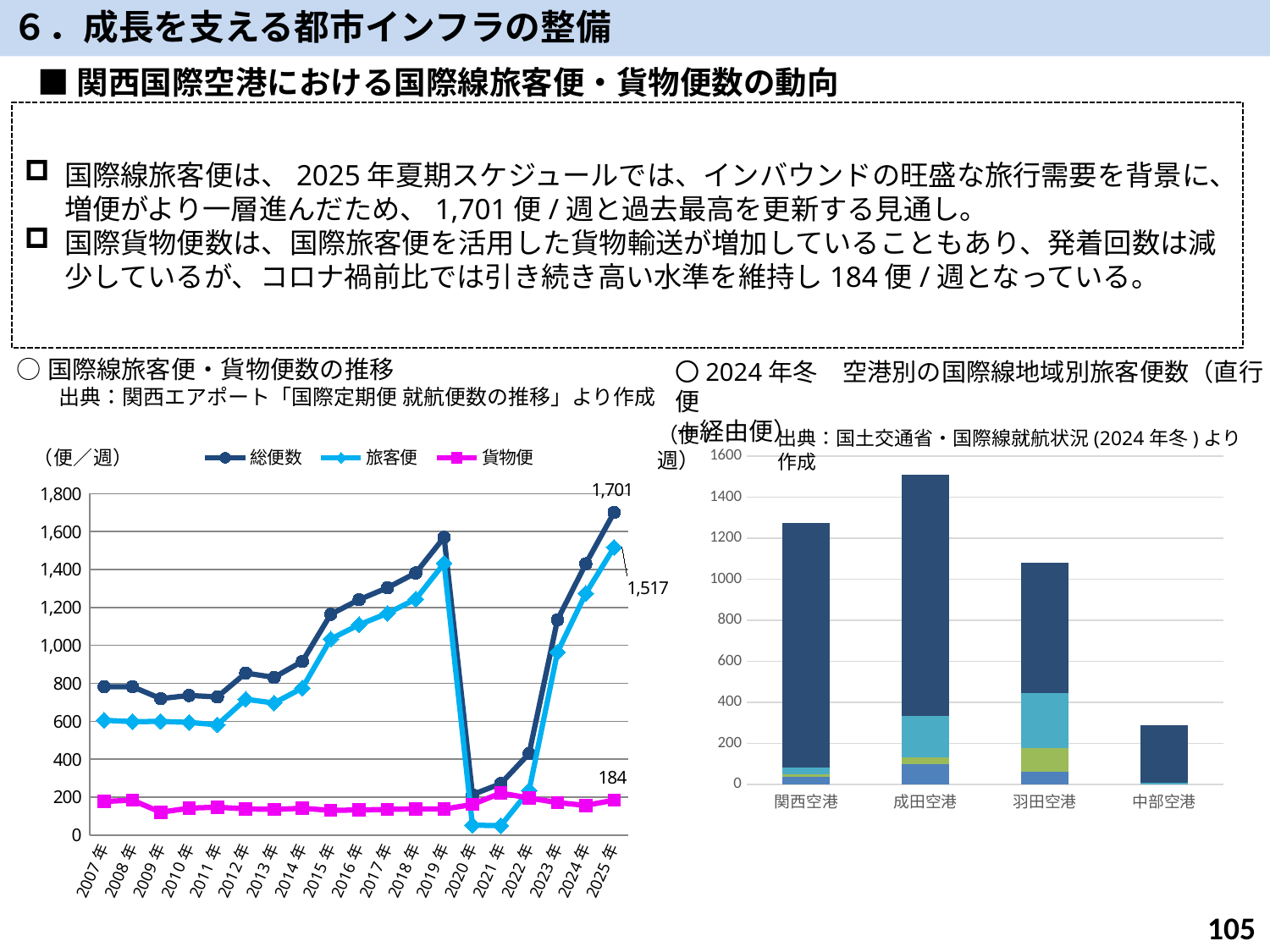
In the left chart 国際線旅客便・貨物便数の推移, how many years are shown on the x axis? 19 In the left chart 国際線旅客便・貨物便数の推移, what is the value of 旅客便 for 2025年? 1,517 In the left chart 国際線旅客便・貨物便数の推移, how many series does the legend list? 3 In the right chart 2024年冬 空港別の国際線地域別旅客便数, how many airports are shown? 4 In the right chart 2024年冬 空港別の国際線地域別旅客便数, which airport has the tallest bar? 成田空港 In the left chart 国際線旅客便・貨物便数の推移, what is the value of 総便数 for 2025年? 1,701 In the left chart 国際線旅客便・貨物便数の推移, what is the value of 貨物便 for 2025年? 184 In the right chart 2024年冬 空港別の国際線地域別旅客便数, which airport has the shortest bar? 中部空港 What kind of chart is the right chart titled 2024年冬 空港別の国際線地域別旅客便数? bar chart In the left chart 国際線旅客便・貨物便数の推移, what is the difference between 総便数 and 旅客便 in 2025年? 184 In the left chart 国際線旅客便・貨物便数の推移, is the value of 総便数 for 2020年 greater or less than 400? less What kind of chart is the left chart titled 国際線旅客便・貨物便数の推移? line chart